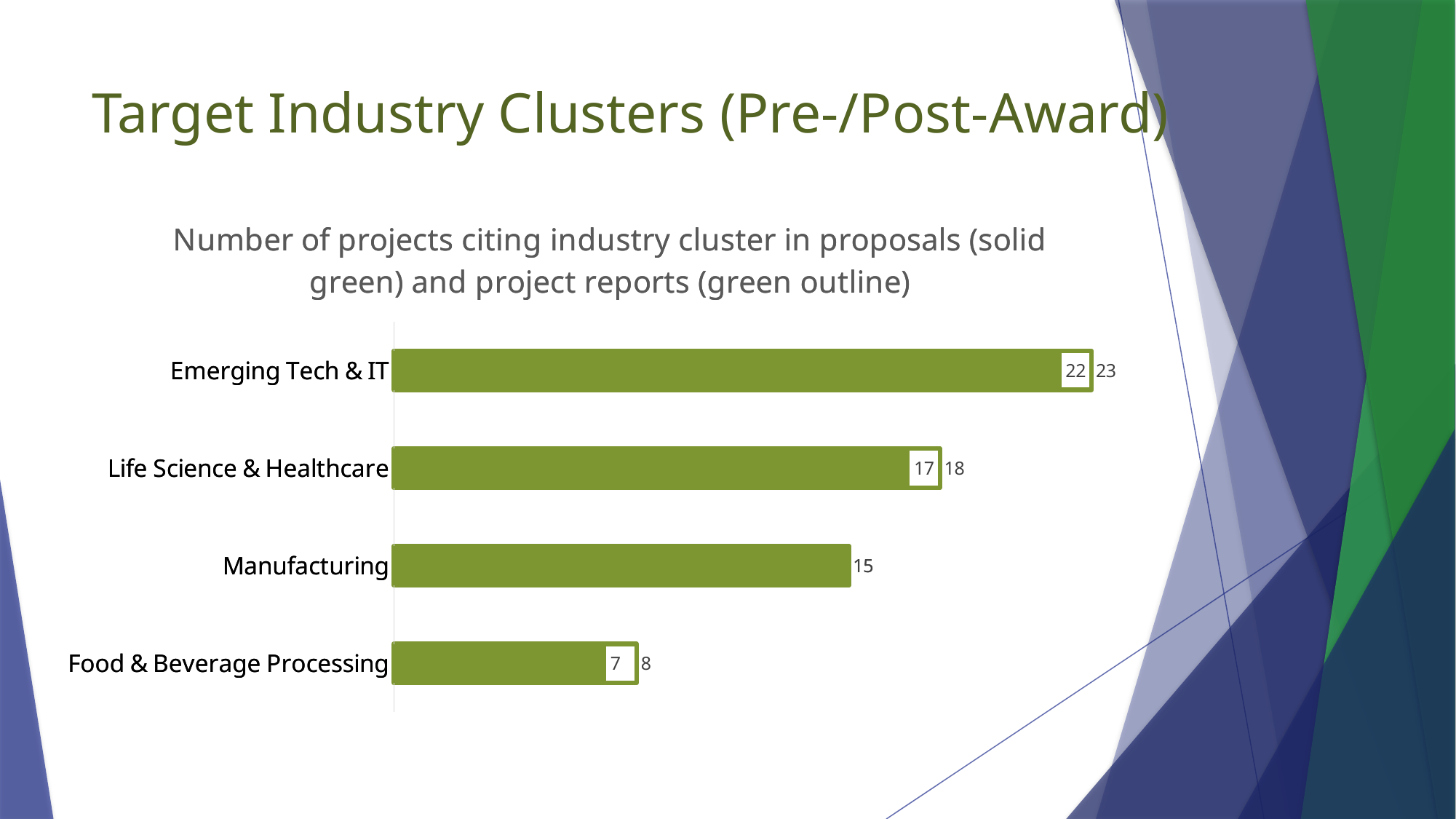
What is the number of projects citing Food & Beverage Processing in project reports (green outline)? 8 What is the number of projects citing Life Science & Healthcare in project reports (green outline)? 18 Which industry cluster has the lowest number of projects citing it in proposals? Food & Beverage Processing What is the number of projects citing Emerging Tech & IT in proposals (solid green)? 22 Which industry cluster has the highest number of projects citing it in proposals? Emerging Tech & IT What is the number of projects citing Emerging Tech & IT in project reports (green outline)? 23 What is the difference between the proposal counts for Emerging Tech & IT and Life Science & Healthcare? 5 How many industry clusters are listed on the chart? 4 What type of chart is shown on the slide? bar chart What is the number of projects citing Life Science & Healthcare in proposals (solid green)? 17 What value is labelled for Manufacturing? 15 Which has more projects citing it in project reports, Life Science & Healthcare or Food & Beverage Processing? Life Science & Healthcare